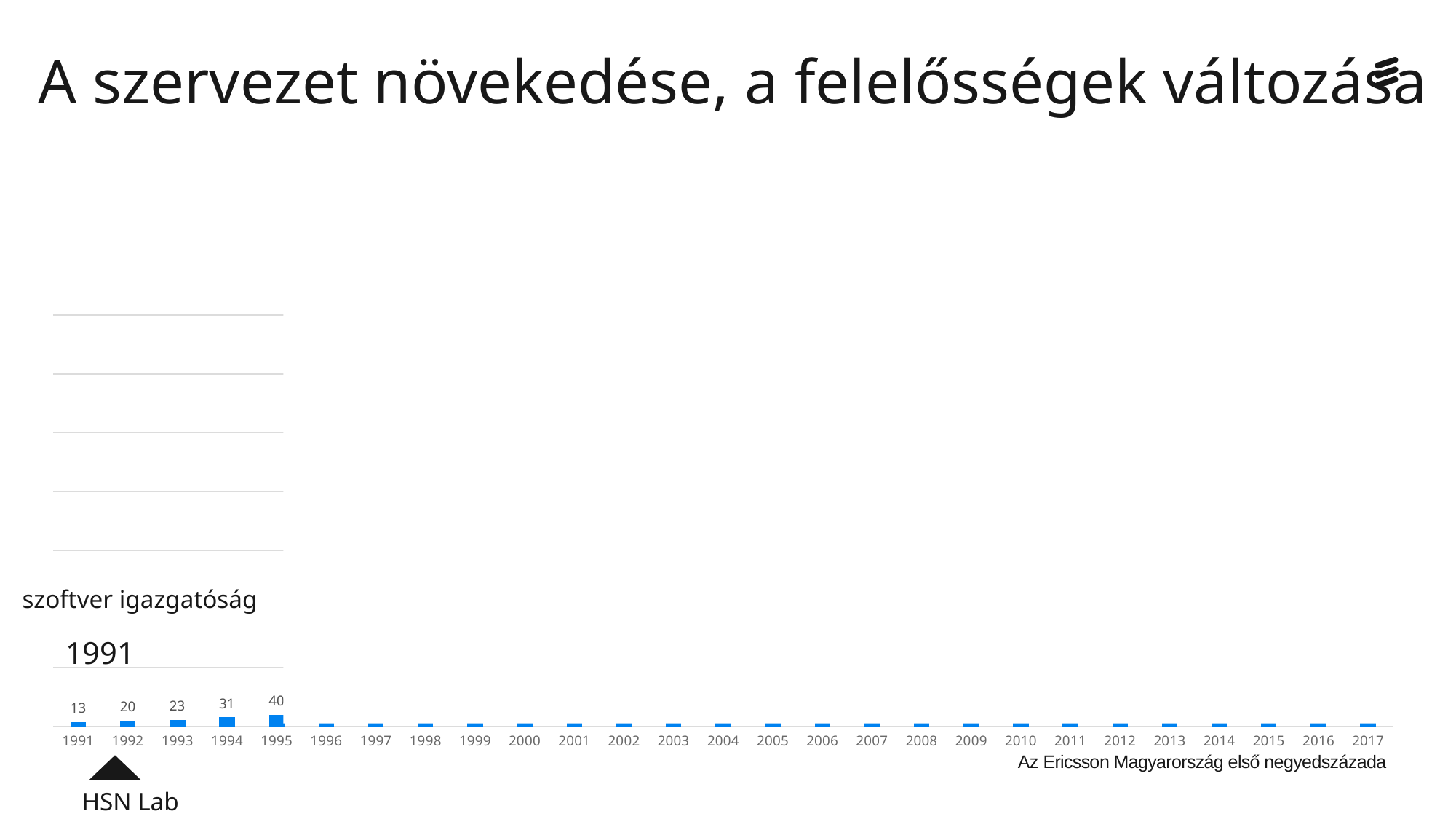
How many years are shown on the x axis? 27 What is the value for 1993? 23 What is the value for 1991? 13 What is the first year shown on the x axis? 1991 What is the difference between the values for 1995 and 1991? 27 What kind of chart is this? bar chart Which is larger, the value for 1992 or the value for 1993? 1993 What is the difference between the values for 1994 and 1992? 11 Do the values rise or fall from 1991 to 1995? rise What is the value for 1994? 31 What is the value for 1995? 40